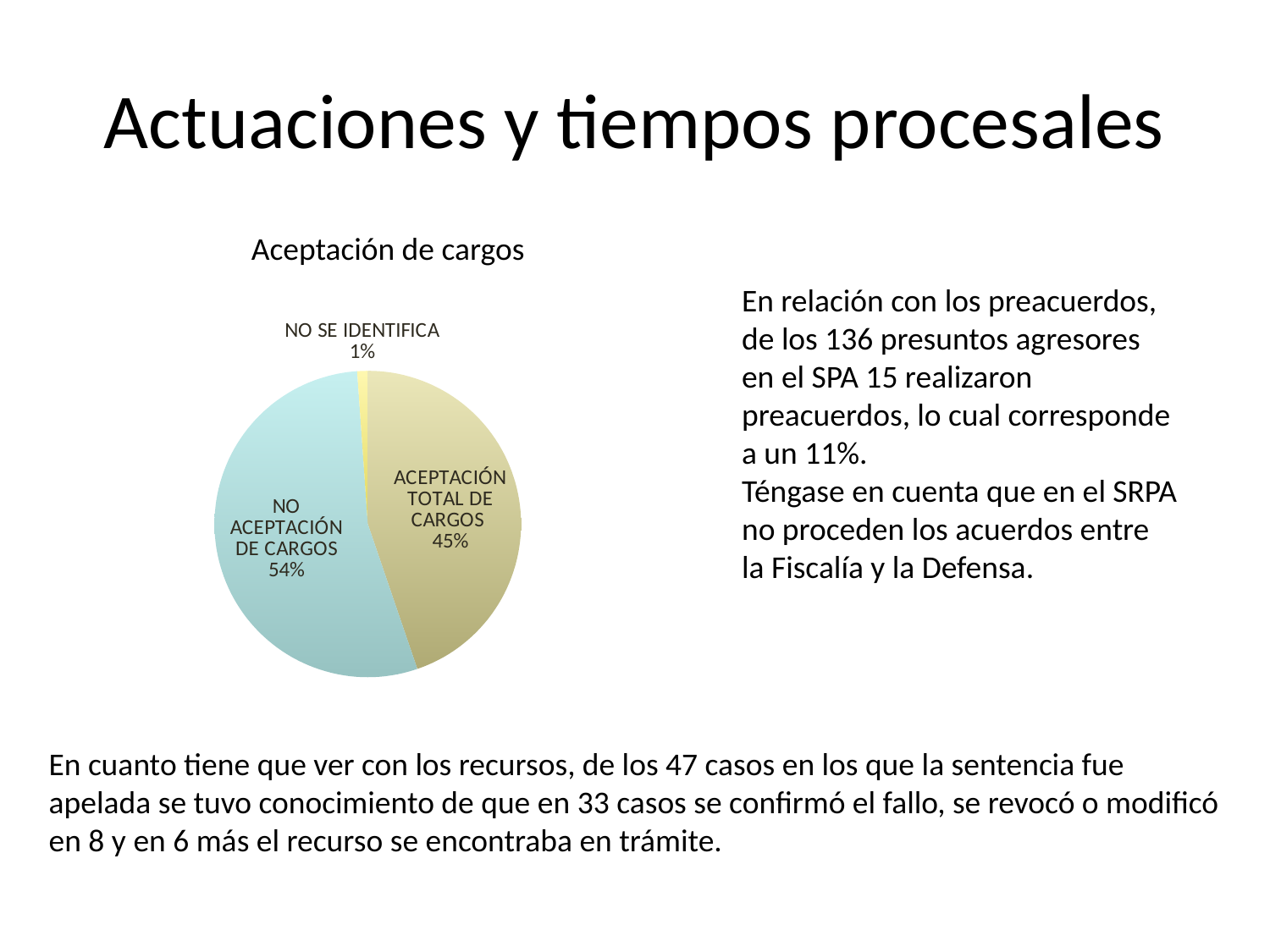
What share of the pie does NO ACEPTACIÓN DE CARGOS represent? 54% How many slices does the pie chart have? 3 What is the difference in percentage points between NO ACEPTACIÓN DE CARGOS and ACEPTACIÓN TOTAL DE CARGOS? 9 What share of the pie does NO SE IDENTIFICA represent? 1% What is the difference in percentage points between ACEPTACIÓN TOTAL DE CARGOS and NO SE IDENTIFICA? 44 Which is larger, the share for ACEPTACIÓN TOTAL DE CARGOS or the share for NO SE IDENTIFICA? ACEPTACIÓN TOTAL DE CARGOS What is the title of the chart? Aceptación de cargos What share of the pie does ACEPTACIÓN TOTAL DE CARGOS represent? 45% What type of chart is shown on the slide? pie chart What colour is the NO ACEPTACIÓN DE CARGOS slice? light blue Which category has the smallest slice of the pie? NO SE IDENTIFICA Which category has the largest slice of the pie? NO ACEPTACIÓN DE CARGOS